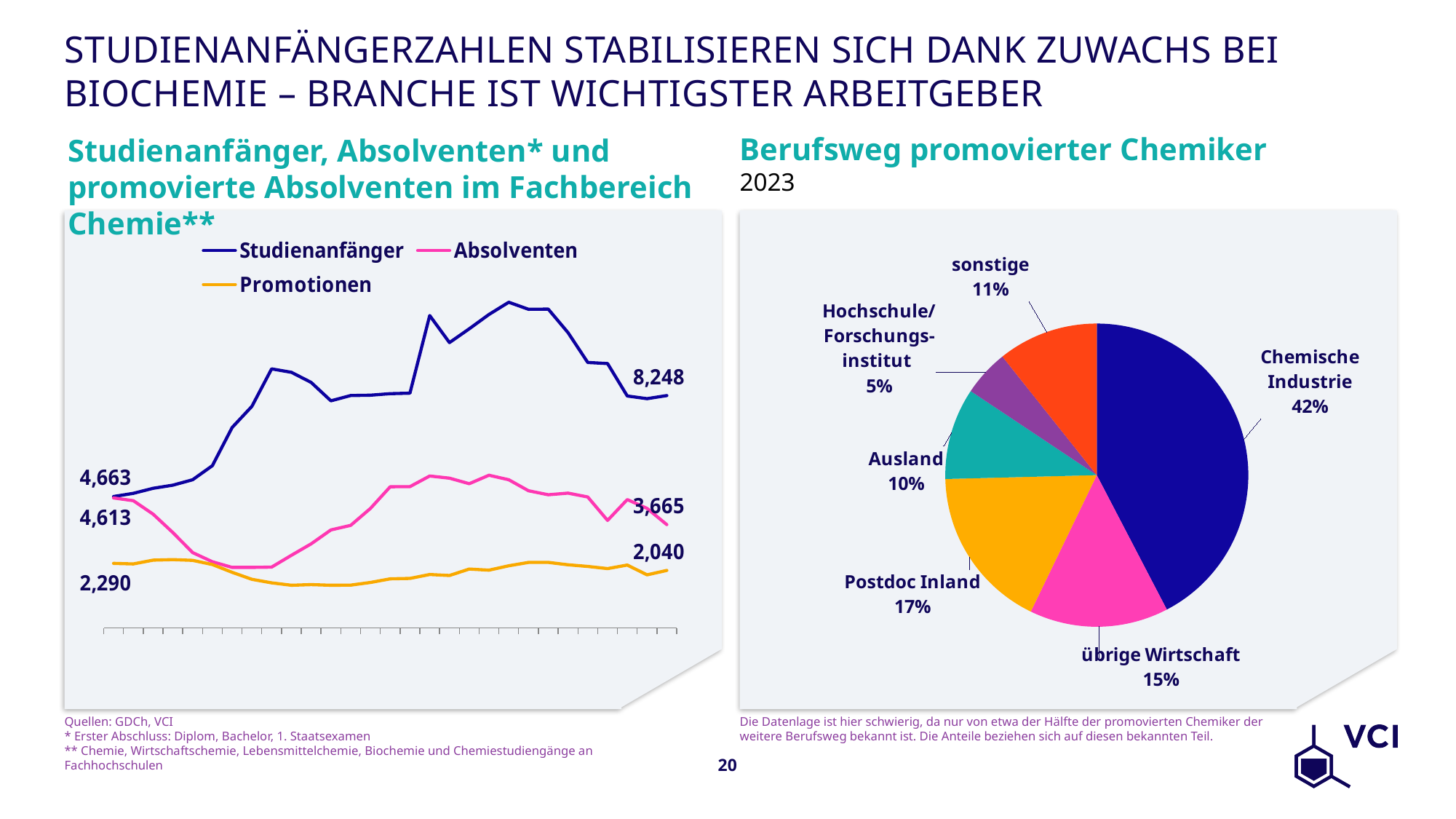
In the pie chart 'Berufsweg promovierter Chemiker', which is larger: Postdoc Inland or übrige Wirtschaft? Postdoc Inland In the left chart (Studienanfänger, Absolventen und promovierte Absolventen), what is the final value shown for Studienanfänger? 8,248 In the pie chart 'Berufsweg promovierter Chemiker', how many slices are there? 6 In the left chart, does the Promotionen line end higher or lower than it starts? lower In the pie chart 'Berufsweg promovierter Chemiker', what is the difference between the shares of Ausland and sonstige? 1% In the pie chart 'Berufsweg promovierter Chemiker', what share does Chemische Industrie have? 42% In the left chart, what is the final value shown for Absolventen? 3,665 In the pie chart 'Berufsweg promovierter Chemiker', which category has the smallest share? Hochschule/Forschungsinstitut In the left chart, what is the first value shown for Promotionen? 2,290 In the left chart, how many series does the legend list? 3 In the left chart, what is the difference between the first and last labelled values for Studienanfänger? 3,585 What kind of chart is the left chart? line chart